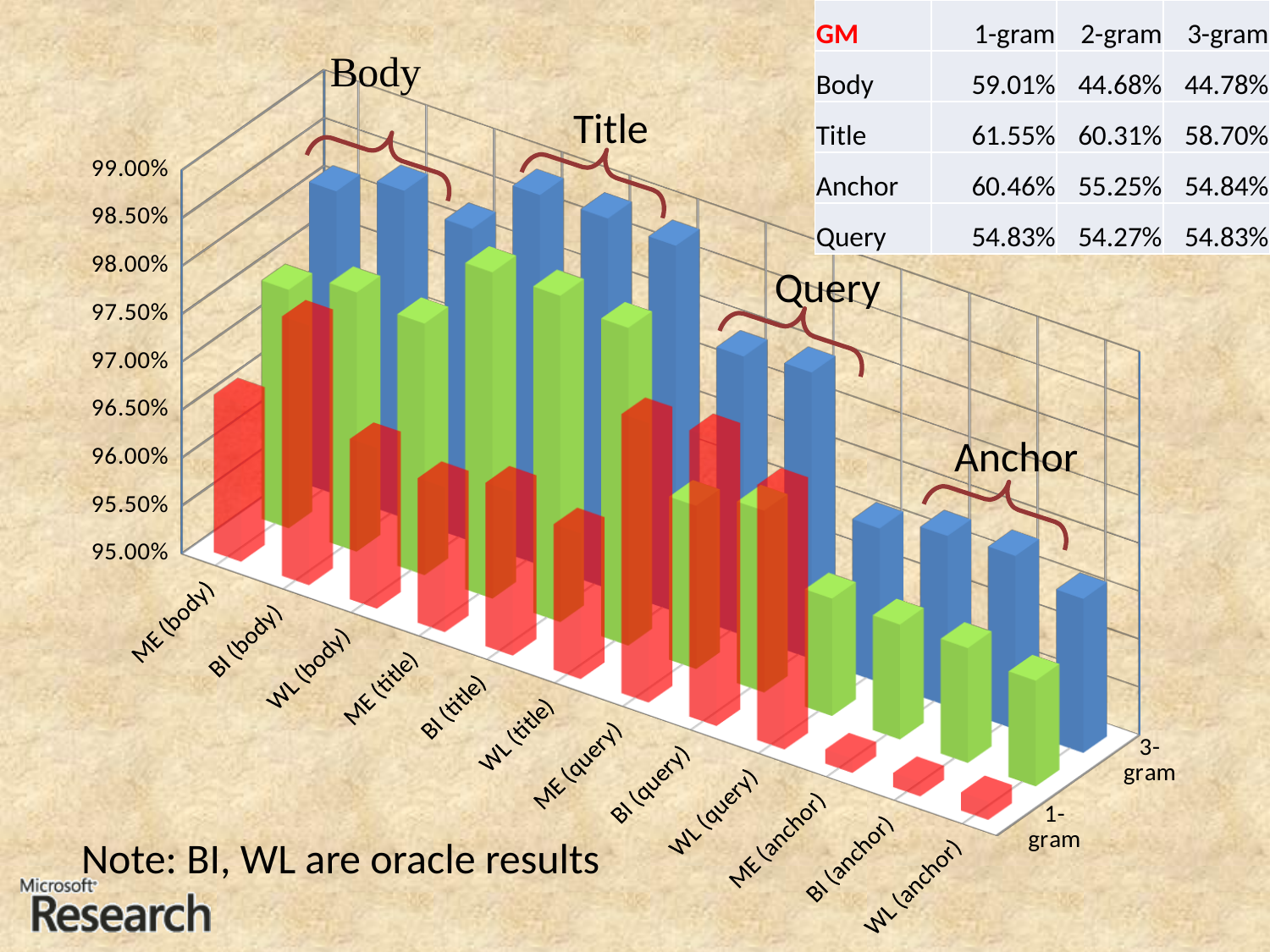
Is the 1-gram value for ME (anchor) greater or less than 95.50%? less What is the lowest value shown on the chart's vertical axis? 95.00% Which group of categories (body, title, query or anchor) has the lowest bars in the chart? anchor According to the note on the slide, which two methods are oracle results? BI, WL Is the 1-gram value for WL (anchor) greater or less than 95.50%? less What is the highest value shown on the chart's vertical axis? 99.00% How many rows (series) of bars does the chart show? 3 What kind of chart is shown on the slide? bar chart Moving along the x axis from the body categories to the anchor categories, do the bar values generally rise or fall? fall Which is larger, the 1-gram value for ME (body) or the 1-gram value for ME (anchor)? ME (body) How many categories are shown along the x axis of the chart? 12 Which is larger, the 3-gram value for BI (body) or the 3-gram value for BI (anchor)? BI (body)